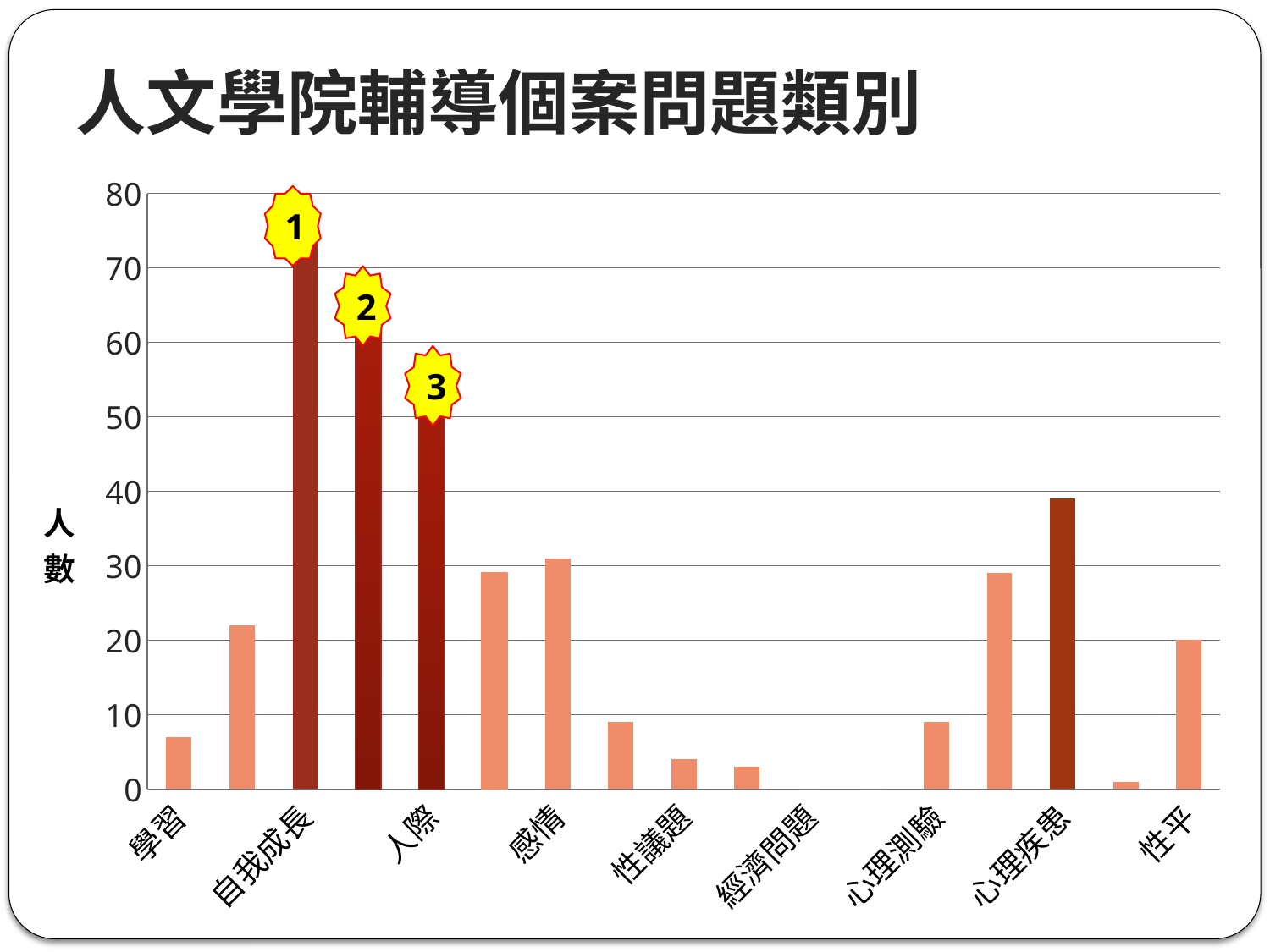
Is the value of the bar marked with rank "2" greater or less than 50? greater Is the value of the bar marked with rank "1" greater or less than 60? greater What is the highest value shown on the vertical axis of the chart? 80 Which rank marker (1, 2 or 3) sits on the tallest bar in the chart? 1 What is the title of the chart? 人文學院輔導個案問題類別 What label is shown on the vertical axis of the chart? 人數 Which is larger, the bar marked with rank "1" or the bar marked with rank "3"? the bar marked with rank "1" What kind of chart is shown on the slide? bar chart Is the value of the bar marked with rank "3" greater or less than 60? less